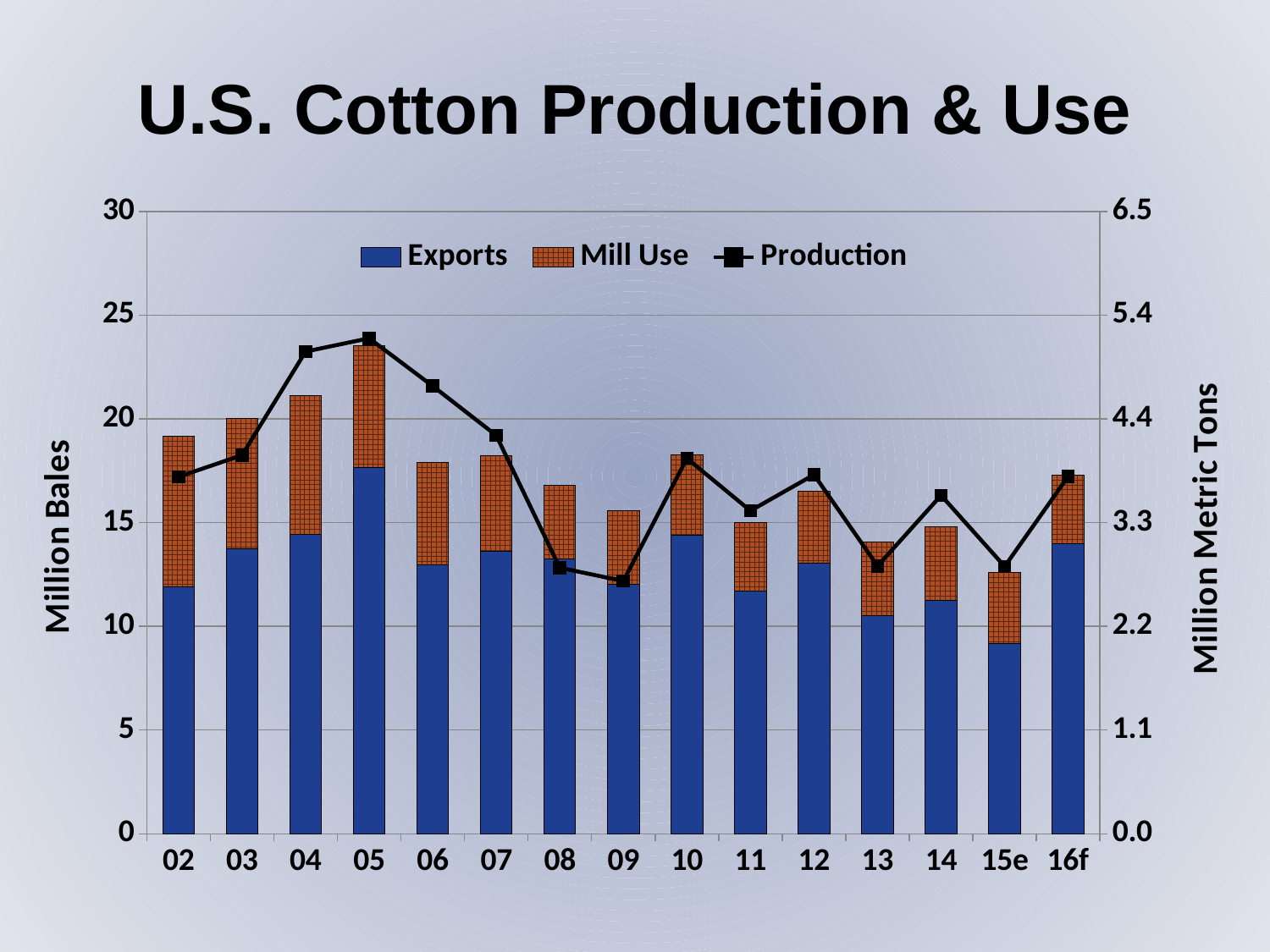
Is the Production value for 04 greater or less than 4.4 million metric tons? greater Is the value for Exports in 15e greater or less than 10 million bales? less In which year is Production lowest? 09 Is the value for Exports in 05 greater or less than 15 million bales? greater In which year are Exports highest? 05 How many series does the legend list? 3 Does Production rise or fall from 05 to 09? Fall Which axis label is shown on the right-hand axis? Million Metric Tons What kind of chart is shown on the slide? Bar chart with a line In which year is Production highest? 05 How many years are shown along the x axis? 15 In which year are Exports lowest? 15e